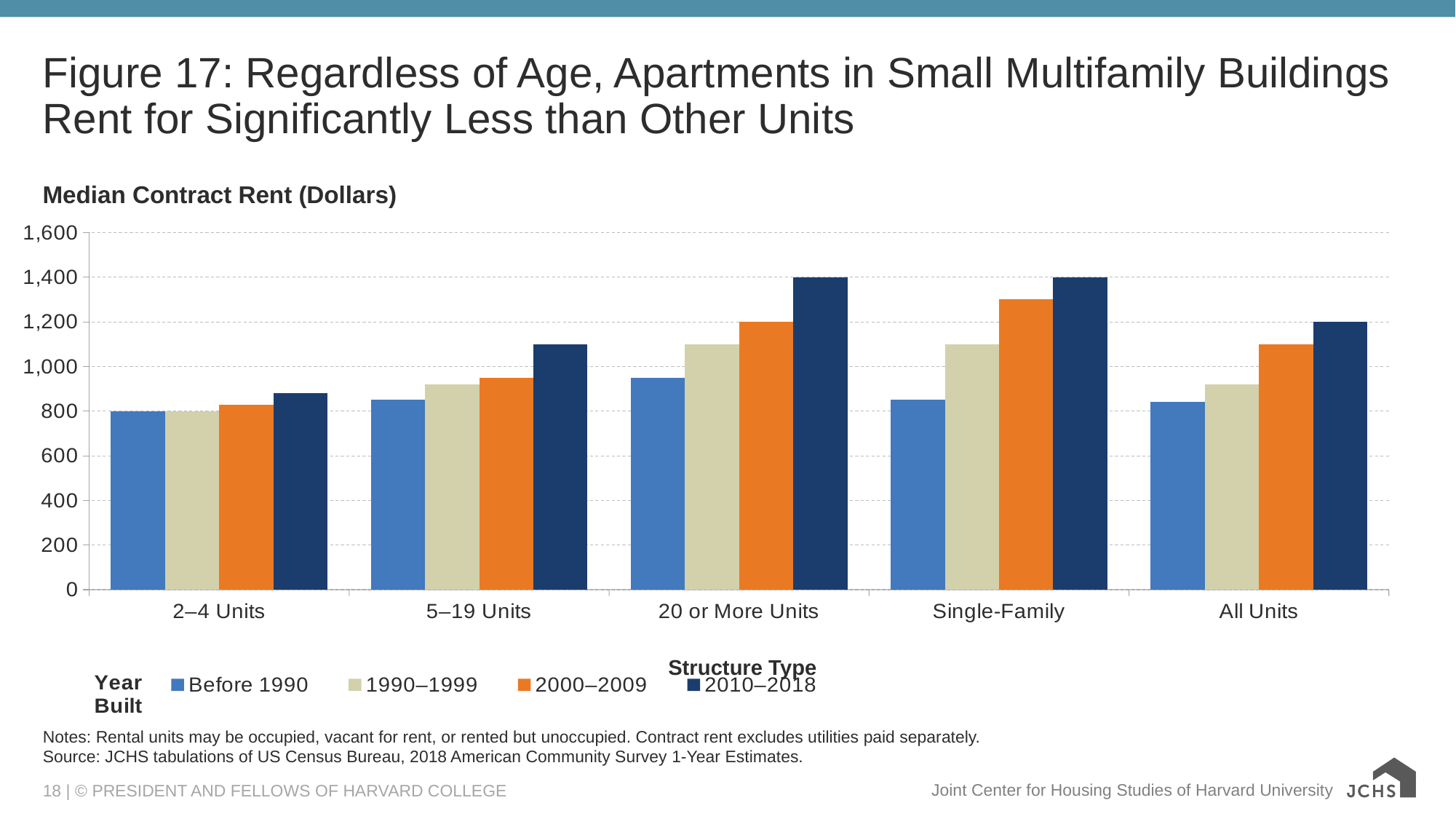
How many structure types are shown along the x axis? 5 For 2–4 Units, which year-built group has the highest median contract rent? 2010–2018 For Single-Family units, which year-built group has the lowest median contract rent? Before 1990 Is the median contract rent for 5–19 Units built 2010–2018 greater or less than 1,000? greater What is the axis title shown above the chart? Median Contract Rent (Dollars) Which year-built series is shown in orange? 2000–2009 How many year-built series does the legend list? 4 For units built 2000–2009, which has the higher median contract rent: Single-Family or 20 or More Units? Single-Family Is the median contract rent for Single-Family units built 2000–2009 greater or less than 1,200? greater What kind of chart is shown on the slide? bar chart Is the median contract rent for All Units built Before 1990 greater or less than 1,000? less